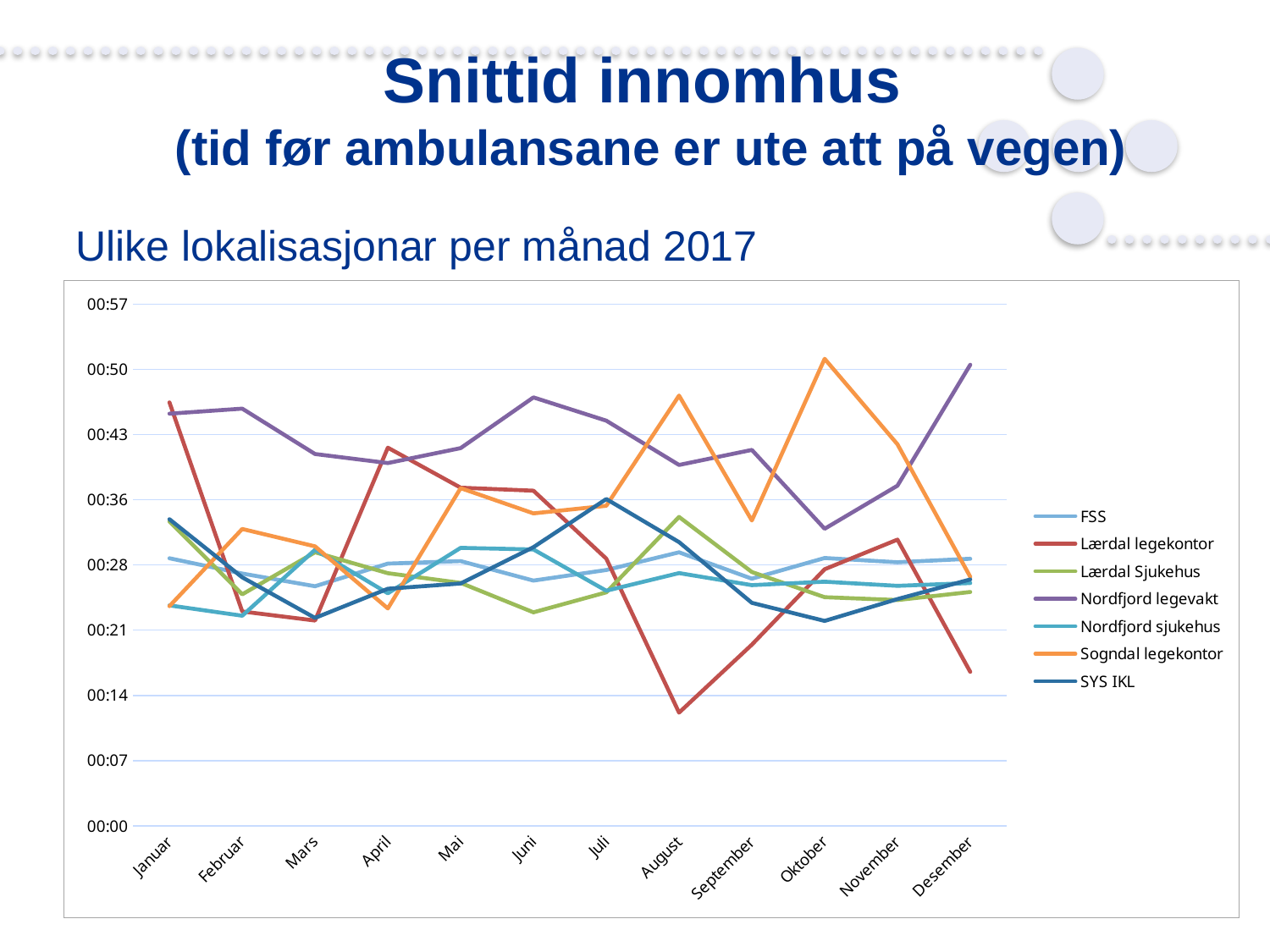
Is the value for Lærdal legekontor in August greater or less than 00:14? less How many series does the legend list? 7 Is the value for Lærdal legekontor in Desember greater or less than 00:21? less Which series has the highest value in Oktober? Sogndal legekontor In Juni, which is larger: Nordfjord legevakt or FSS? Nordfjord legevakt Is the value for Nordfjord legevakt in Desember greater or less than 00:43? greater What kind of chart is shown on the slide? line chart Which series has the lowest value in August? Lærdal legekontor Which series has the highest value in Desember? Nordfjord legevakt Does the Sogndal legekontor line rise or fall from Oktober to Desember? fall How many months are plotted along the x axis? 12